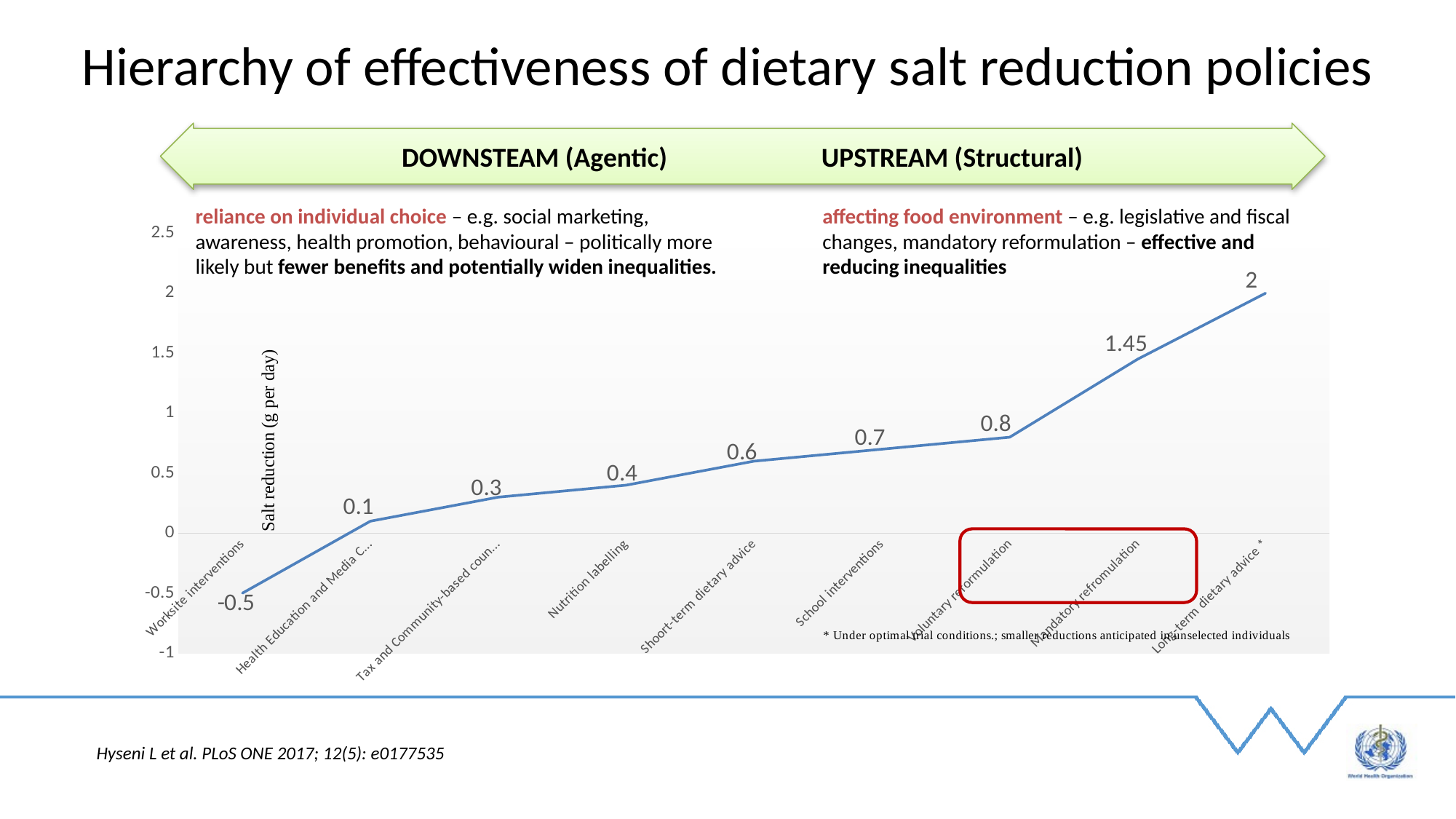
What is the salt reduction value for Nutrition labelling? 0.4 What is the salt reduction value for Worksite interventions? -0.5 What is the difference between the values for Mandatory reformulation and Voluntary reformulation? 0.65 What is the salt reduction value for Mandatory reformulation? 1.45 How many categories are plotted on the chart? 9 Which category has the lowest salt reduction value? Worksite interventions What kind of chart is shown on the slide? Line chart Do the values rise or fall from left to right along the x axis? Rise What is the salt reduction value for School interventions? 0.7 Which is larger, the value for Shoort-term dietary advice or the value for Nutrition labelling? Shoort-term dietary advice Which category has the highest salt reduction value? Long-term dietary advice * What is the label of the vertical axis? Salt reduction (g per day)